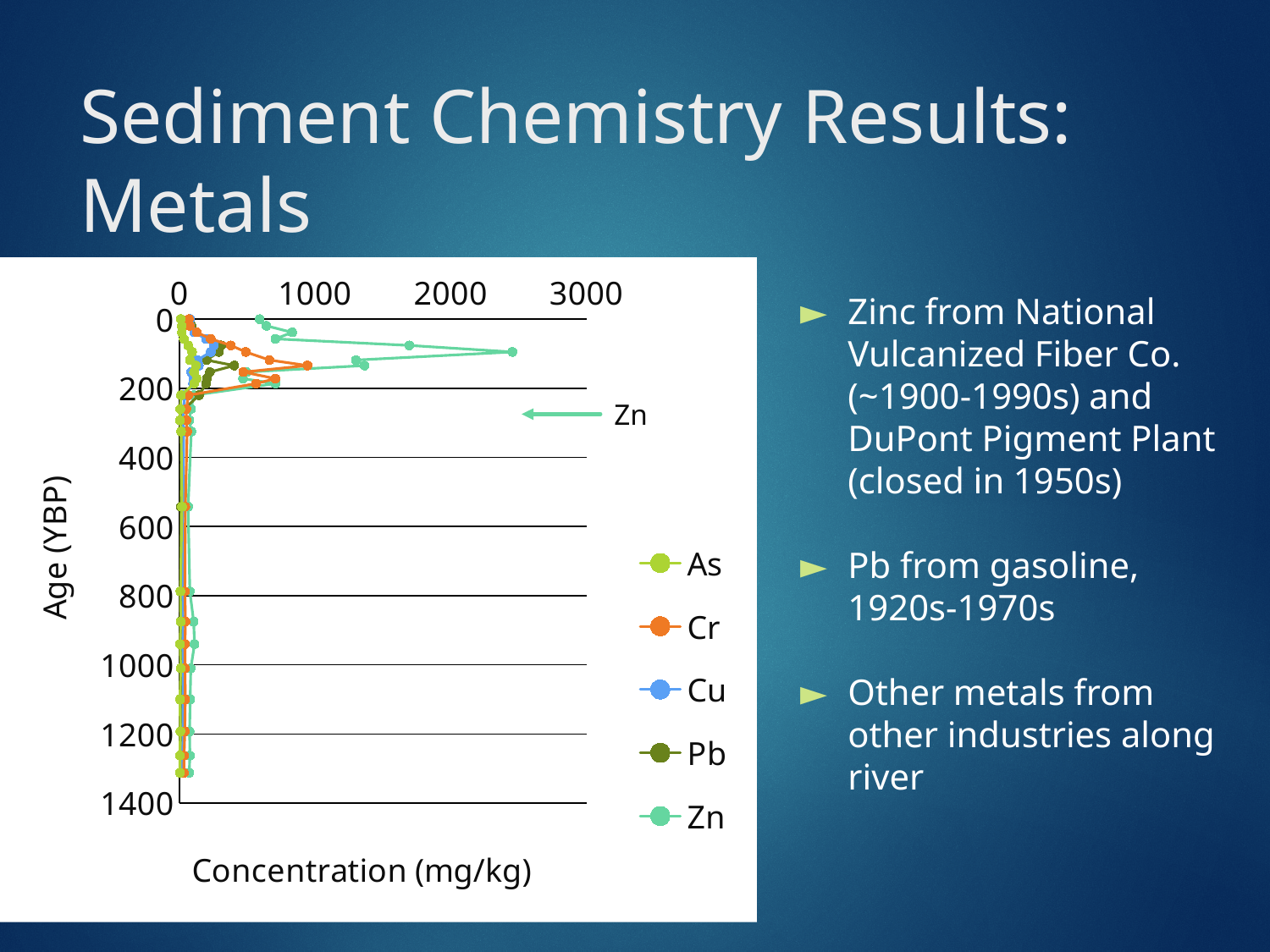
Which metals are listed in the chart legend? As, Cr, Cu, Pb, Zn What is the label of the horizontal axis? Concentration (mg/kg) What kind of chart is shown on the slide? line chart Is the peak concentration of Zn greater or less than 2000 mg/kg? greater Is the peak concentration of Cr greater or less than 2000 mg/kg? less Do the metal concentrations generally rise or fall as age (YBP) increases beyond about 200 years? fall How many series does the legend list? 5 Which metal reaches the highest concentration on the chart? Zn Which has a higher peak concentration, Cr or Cu? Cr Is the Zn peak concentration greater or less than 3000 mg/kg? less Which has a higher peak concentration, Zn or Cr? Zn